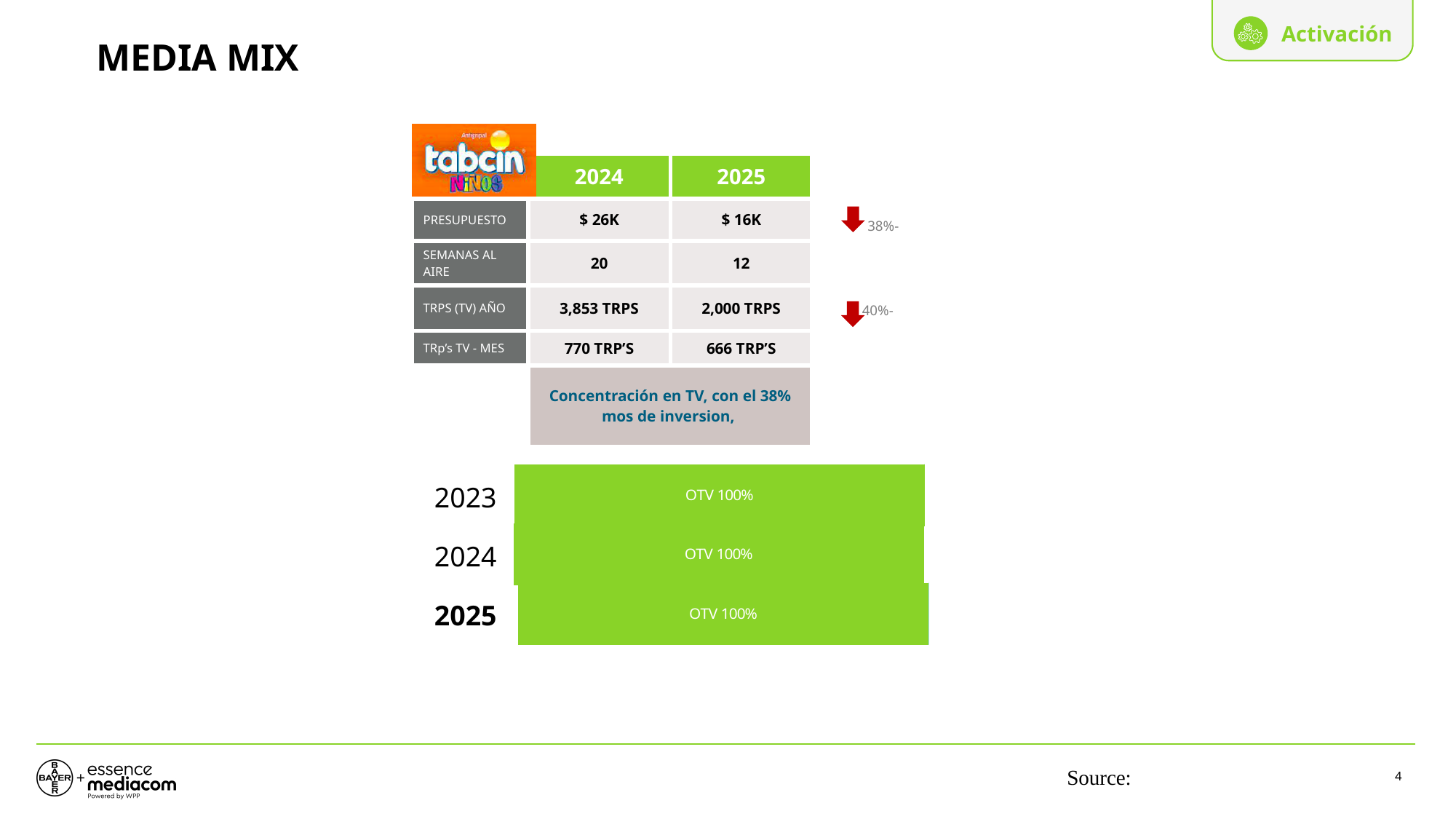
What kind of chart is shown at the bottom of the slide? bar chart Does the OTV share in the bar chart rise, fall or stay the same from 2023 to 2025? stays the same In the bar chart, what share does OTV have for 2025? OTV 100% Which media channel is the only one shown in the bar chart for all three years? OTV Which years are listed as categories in the bar chart? 2023, 2024, 2025 In the bar chart, what share does OTV have for 2024? OTV 100% What is the total of the 2025 bar in the bar chart? 100% How many years (bars) does the bar chart show? 3 In the bar chart, what share does OTV have for 2023? OTV 100%